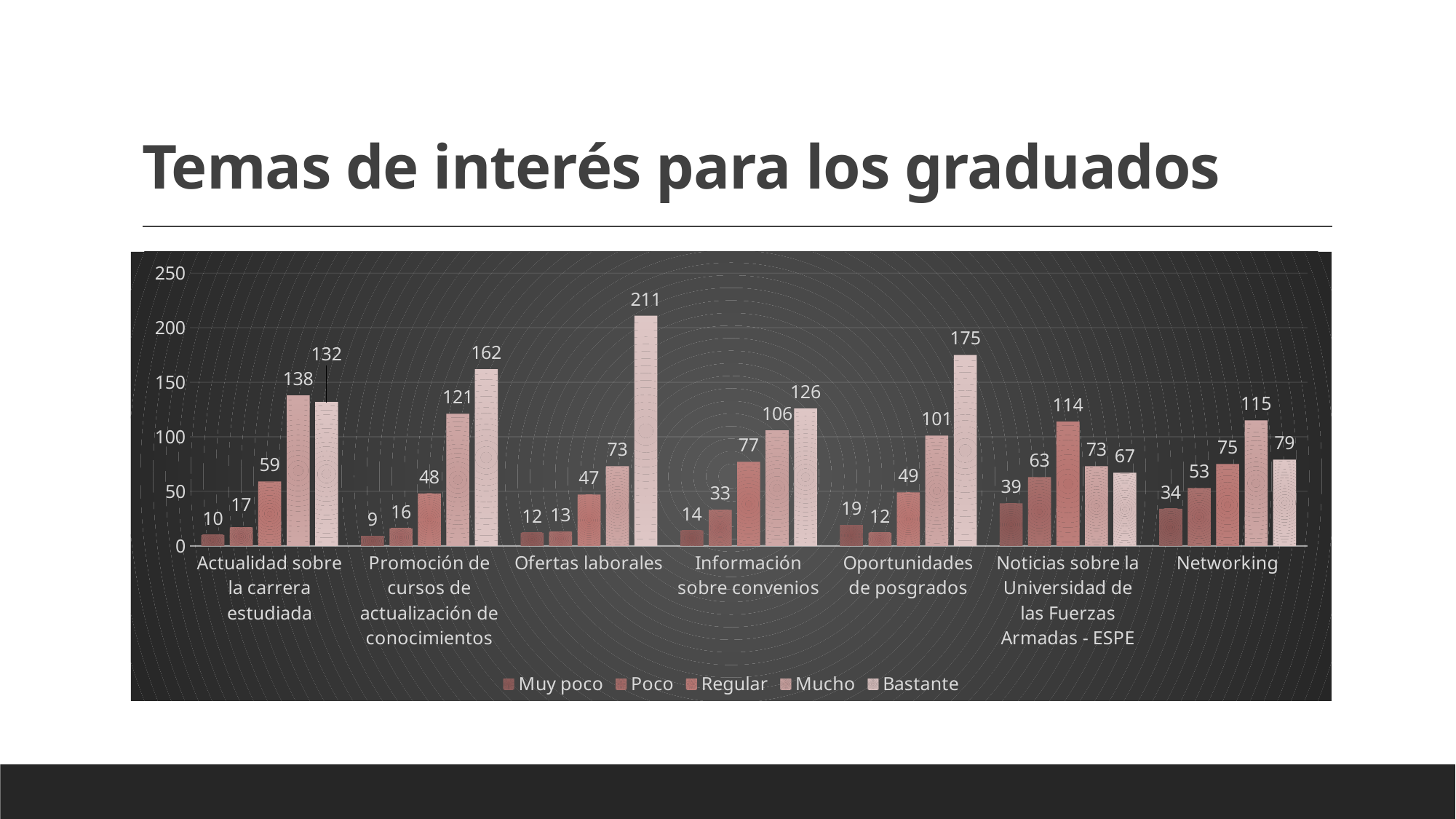
What is the difference between the Bastante and Mucho values for Oportunidades de posgrados? 74 Which category has the lowest Muy poco value? Promoción de cursos de actualización de conocimientos What is the value for Regular in the Noticias sobre la Universidad de las Fuerzas Armadas - ESPE category? 114 What is the value for Bastante in the Ofertas laborales category? 211 What kind of chart is shown on the slide? Bar chart What is the value for Mucho in the Actualidad sobre la carrera estudiada category? 138 Which is larger for Networking: the Mucho value or the Bastante value? Mucho How many categories are shown on the x axis? 7 How many series does the legend list? 5 What is the value for Poco in the Información sobre convenios category? 33 What is the title of the slide? Temas de interés para los graduados Which category has the highest Bastante value? Ofertas laborales